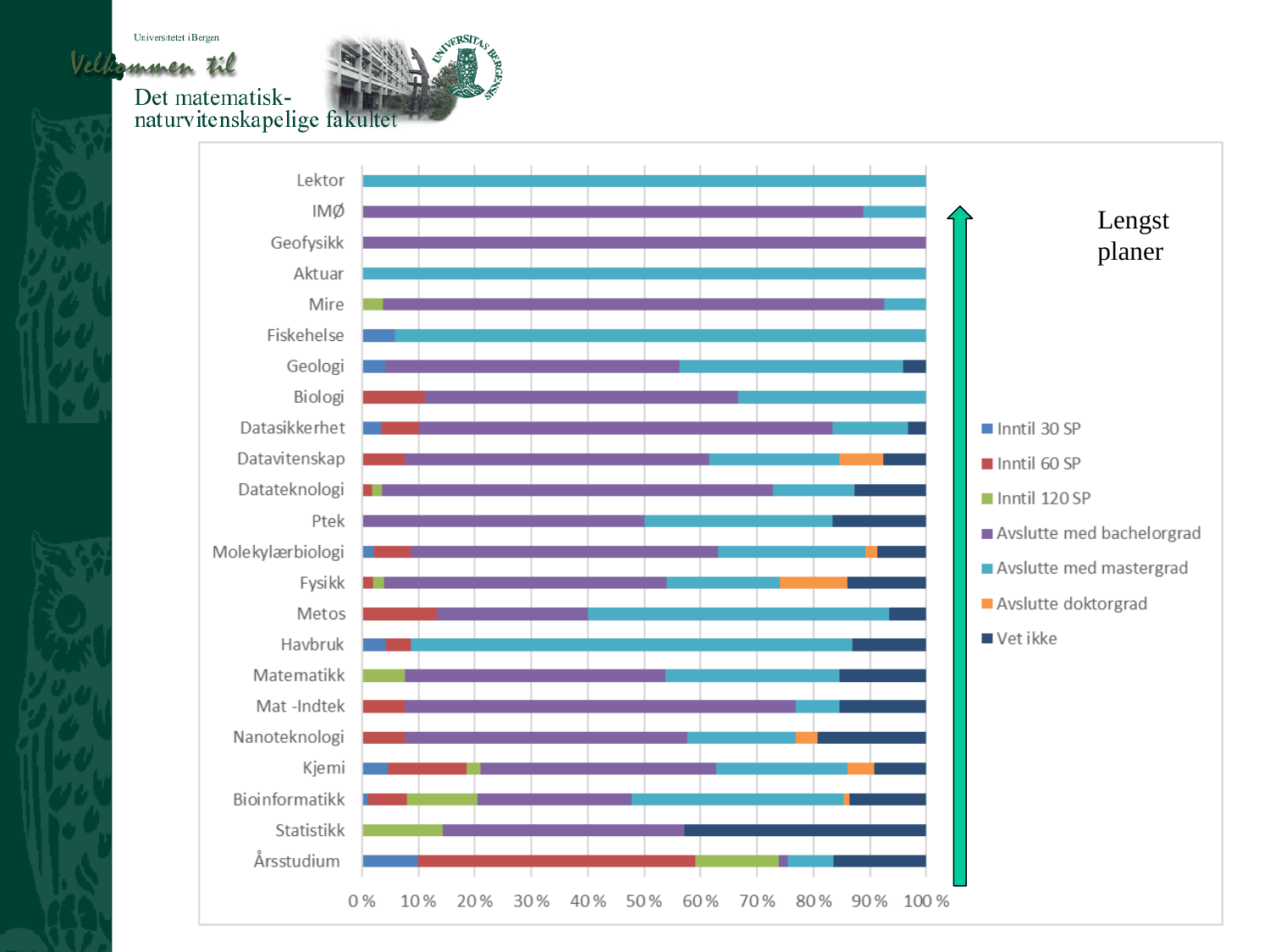
What share of the Lektor bar is 'Avslutte med mastergrad'? 100 % What text is written next to the green arrow to the right of the chart? Lengst planer Which has the larger 'Avslutte med mastergrad' share, Lektor or Årsstudium? Lektor Is the 'Avslutte med bachelorgrad' share for Metos greater or less than 20%? greater Which category is listed at the top of the chart? Lektor What kind of chart is shown on the slide? Stacked bar chart Is the 'Inntil 60 SP' share for Årsstudium greater or less than 40%? greater What share of the Geofysikk bar is 'Avslutte med bachelorgrad'? 100 % Is the 'Vet ikke' share for Statistikk greater or less than 30%? greater What share of the Aktuar bar is 'Avslutte med mastergrad'? 100 % How many series does the chart legend list? 7 How many study programmes (categories) are plotted on the chart? 23